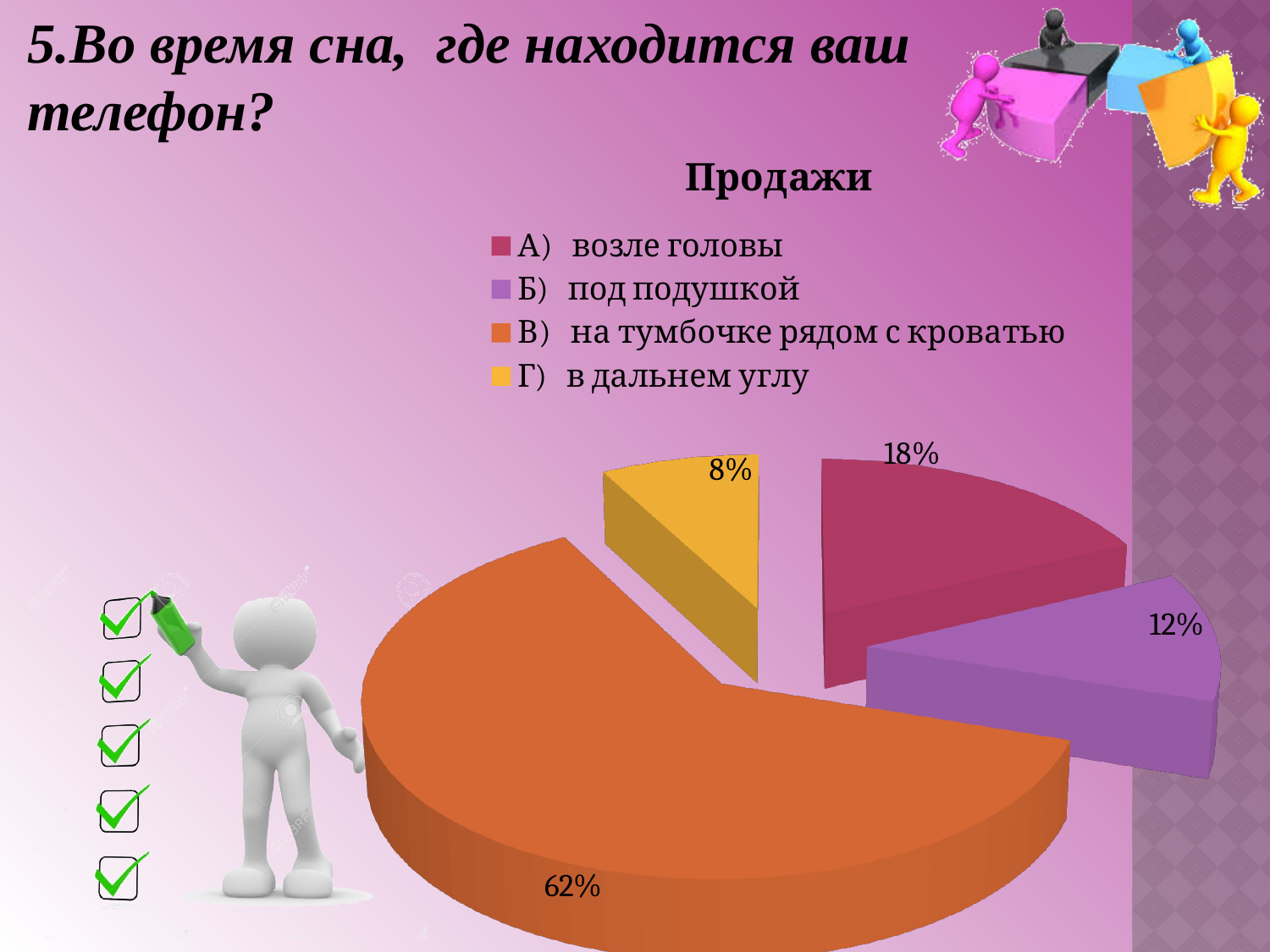
What percentage is shown for "Г) в дальнем углу"? 8% What percentage is shown for "В) на тумбочке рядом с кроватью"? 62% Which category has the largest share of the pie? В) на тумбочке рядом с кроватью Which category has the smallest share of the pie? Г) в дальнем углу What percentage is shown for "Б) под подушкой"? 12% How many slices does the pie chart have? 4 Which is larger: the share for "А) возле головы" or the share for "Г) в дальнем углу"? А) возле головы What is the chart's title? Продажи Which colour represents "Б) под подушкой" in the legend? purple What kind of chart is shown on the slide? pie chart What percentage is shown for "А) возле головы"? 18% What is the difference in percentage points between "А) возле головы" and "Б) под подушкой"? 6